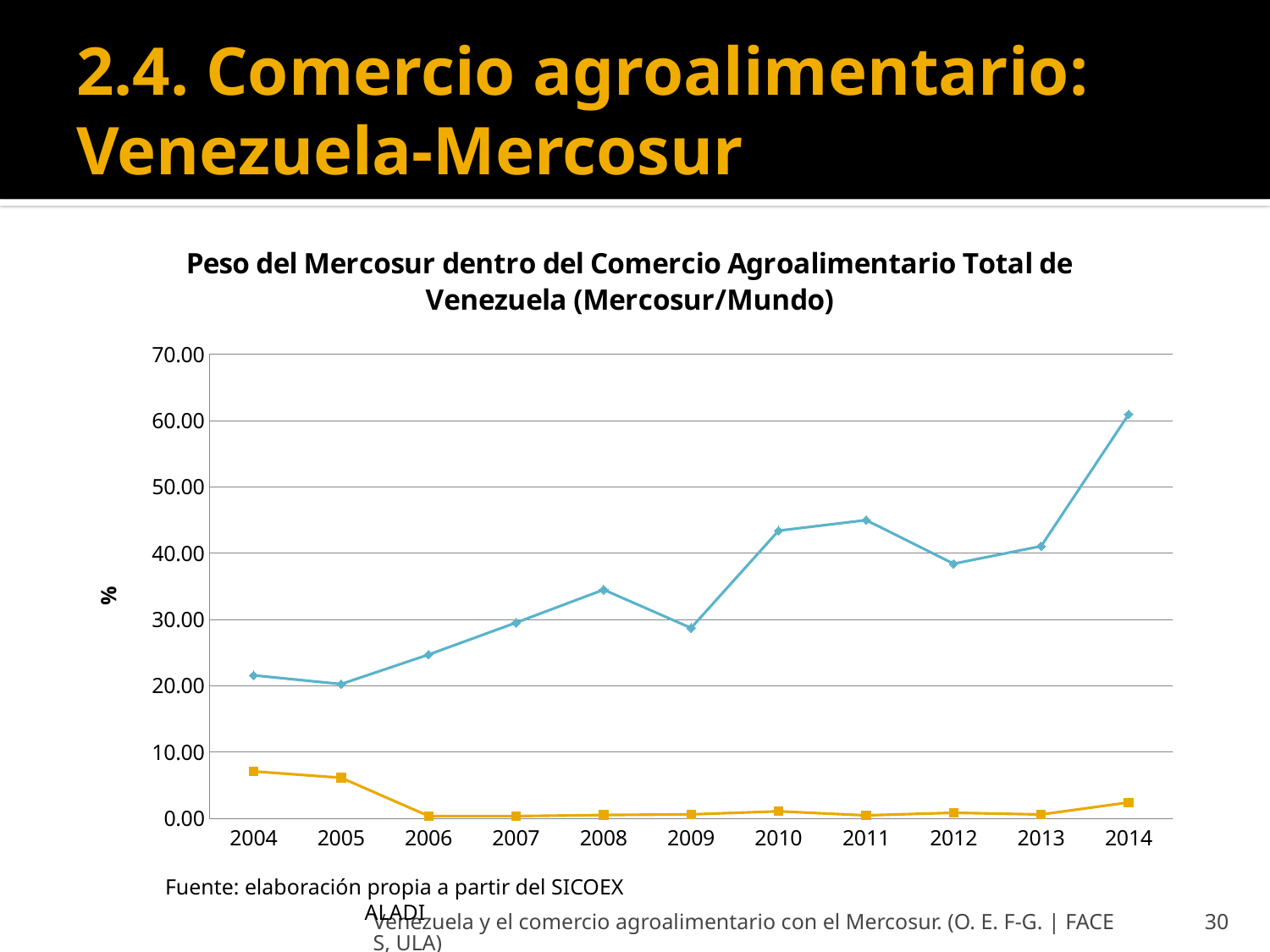
In which year does the orange line reach its highest value? 2004 How many years are plotted along the x axis of the chart? 11 Which line has the higher value in 2010, the blue line or the orange line? the blue line What kind of chart is shown on the slide? line chart Does the blue line generally rise or fall from 2004 to 2014? rise How many lines are plotted in the chart? 2 Is the value of the blue line in 2014 greater or less than 50.00? greater In which year does the blue line reach its highest value? 2014 For the blue line, which year has the higher value, 2011 or 2012? 2011 Is the value of the blue line in 2005 greater or less than 30.00? less What is the label on the vertical axis of the chart? % Is the value of the orange line in 2004 greater or less than 10.00? less